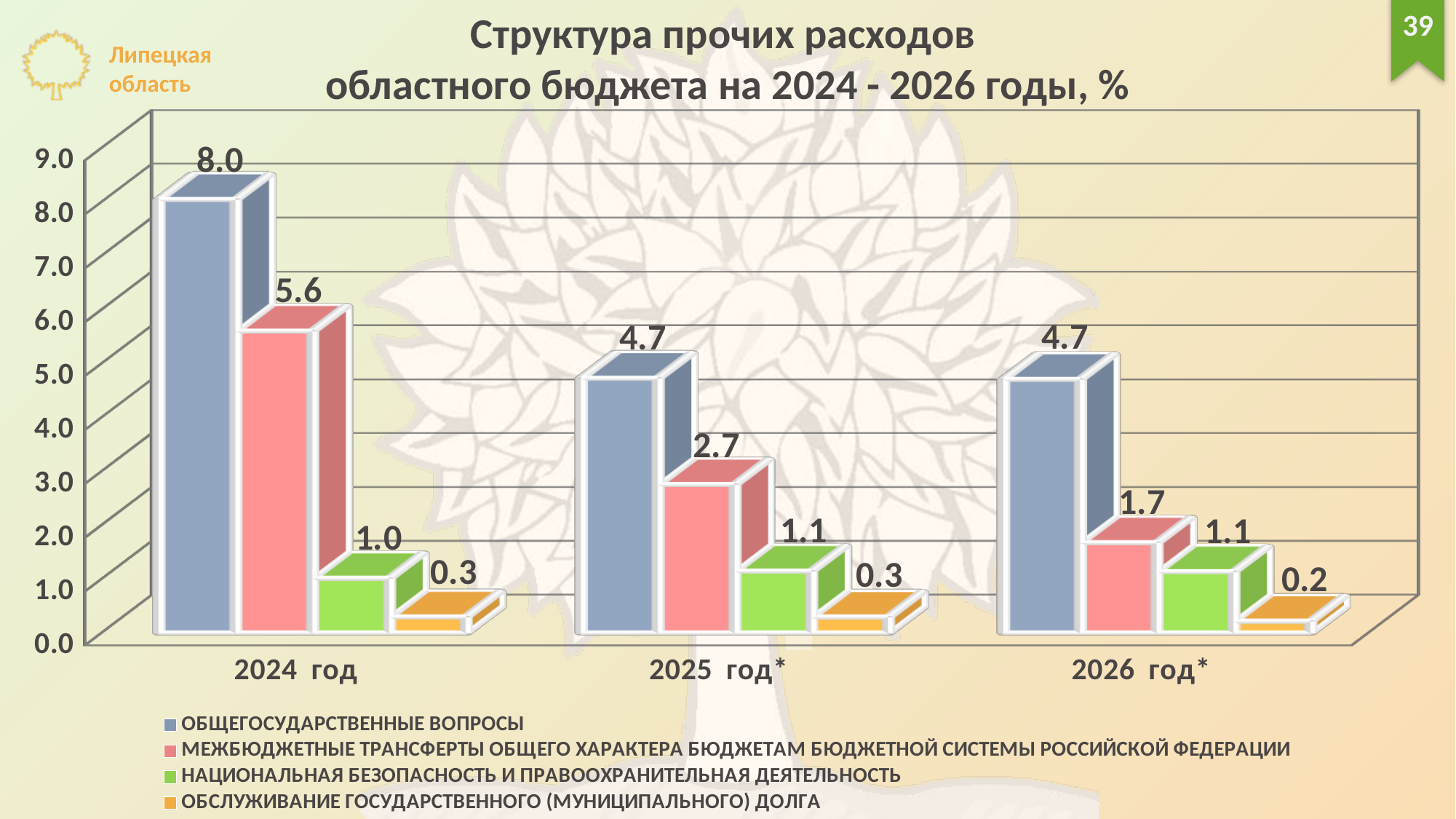
What is the value for МЕЖБЮДЖЕТНЫЕ ТРАНСФЕРТЫ ОБЩЕГО ХАРАКТЕРА БЮДЖЕТАМ БЮДЖЕТНОЙ СИСТЕМЫ РОССИЙСКОЙ ФЕДЕРАЦИИ in 2025 год*? 2.7 In which year is the value for ОБЩЕГОСУДАРСТВЕННЫЕ ВОПРОСЫ highest? 2024 год How many year categories are shown on the x axis? 3 How many series does the legend list? 4 Which series has the lowest value in 2025 год*? ОБСЛУЖИВАНИЕ ГОСУДАРСТВЕННОГО (МУНИЦИПАЛЬНОГО) ДОЛГА What is the difference between the ОБЩЕГОСУДАРСТВЕННЫЕ ВОПРОСЫ values for 2024 год and 2025 год*? 3.3 Does the value for МЕЖБЮДЖЕТНЫЕ ТРАНСФЕРТЫ ОБЩЕГО ХАРАКТЕРА БЮДЖЕТАМ БЮДЖЕТНОЙ СИСТЕМЫ РОССИЙСКОЙ ФЕДЕРАЦИИ rise or fall from 2024 год to 2026 год*? Fall What is the value for ОБЩЕГОСУДАРСТВЕННЫЕ ВОПРОСЫ in 2024 год? 8.0 What is the value for ОБСЛУЖИВАНИЕ ГОСУДАРСТВЕННОГО (МУНИЦИПАЛЬНОГО) ДОЛГА in 2026 год*? 0.2 What is the value for НАЦИОНАЛЬНАЯ БЕЗОПАСНОСТЬ И ПРАВООХРАНИТЕЛЬНАЯ ДЕЯТЕЛЬНОСТЬ in 2024 год? 1.0 What kind of chart is shown on the slide? Bar chart Which is larger: МЕЖБЮДЖЕТНЫЕ ТРАНСФЕРТЫ ОБЩЕГО ХАРАКТЕРА БЮДЖЕТАМ БЮДЖЕТНОЙ СИСТЕМЫ РОССИЙСКОЙ ФЕДЕРАЦИИ in 2025 год* or in 2026 год*? 2025 год*